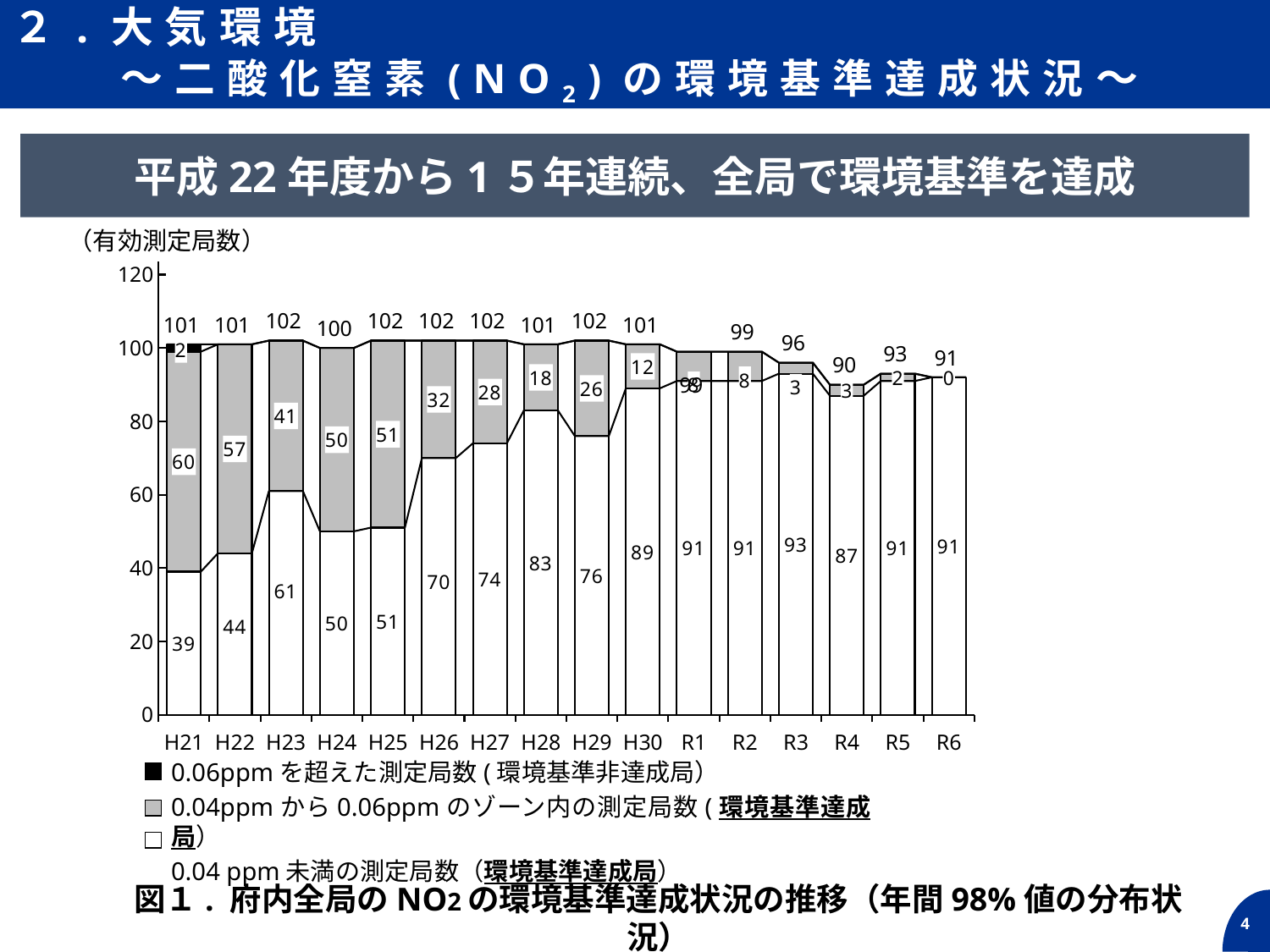
What is the number of stations in the 0.04–0.06 ppm zone (gray segment) for H23? 41 How many fiscal-year categories are shown along the x axis? 16 How many series does the legend list? 3 Which year has the lowest number of stations below 0.04 ppm (white segment)? H21 What is the gray-segment value (0.04–0.06 ppm zone) for R6? 0 Which year has the larger white-segment value, H26 or H27? H27 Which year has the highest number of stations below 0.04 ppm (white segment)? R3 What is the difference between the gray-segment values for H22 and H23? 16 What is the number of stations below 0.04 ppm (white segment) for H21? 39 What is the total number of valid measuring stations for H24? 100 What kind of chart is shown on the slide? Stacked bar chart What is the total number of stations for H21 (the top of the stacked bar)? 101